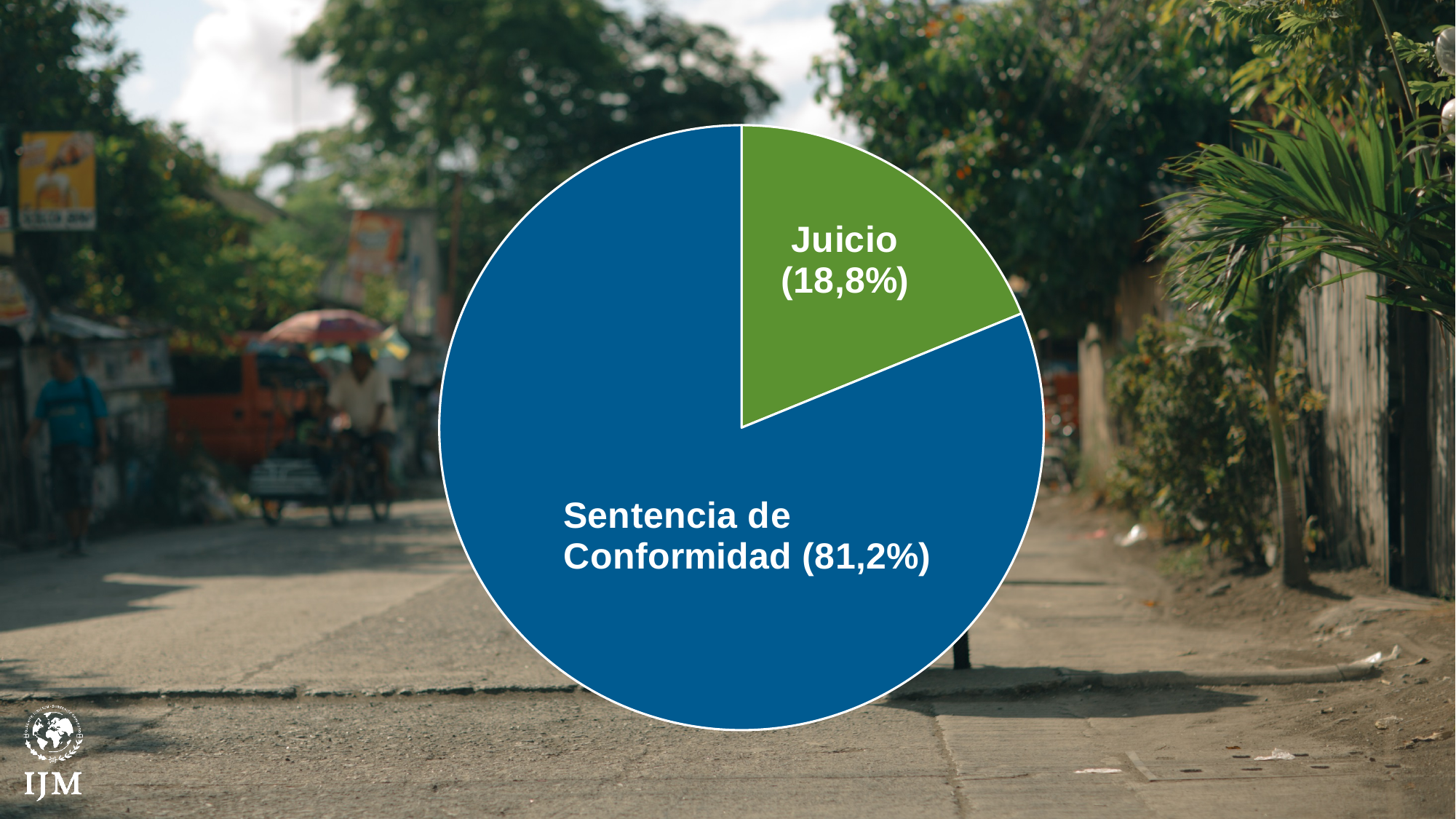
Which is larger, the Juicio slice or the Sentencia de Conformidad slice? Sentencia de Conformidad What share of the pie does the Juicio slice represent? 18,8% What kind of chart is shown on the slide? pie chart Is the share for Juicio greater or less than 25%? less What colour is the Sentencia de Conformidad slice of the pie? blue What colour is the Juicio slice of the pie? green Which slice of the pie is the smallest? Juicio Is the share for Sentencia de Conformidad greater or less than 75%? greater What share of the pie does the Sentencia de Conformidad slice represent? 81,2% How many slices does the pie chart have? 2 Which slice of the pie is the largest? Sentencia de Conformidad What is the difference in percentage points between the Sentencia de Conformidad slice and the Juicio slice? 62,4